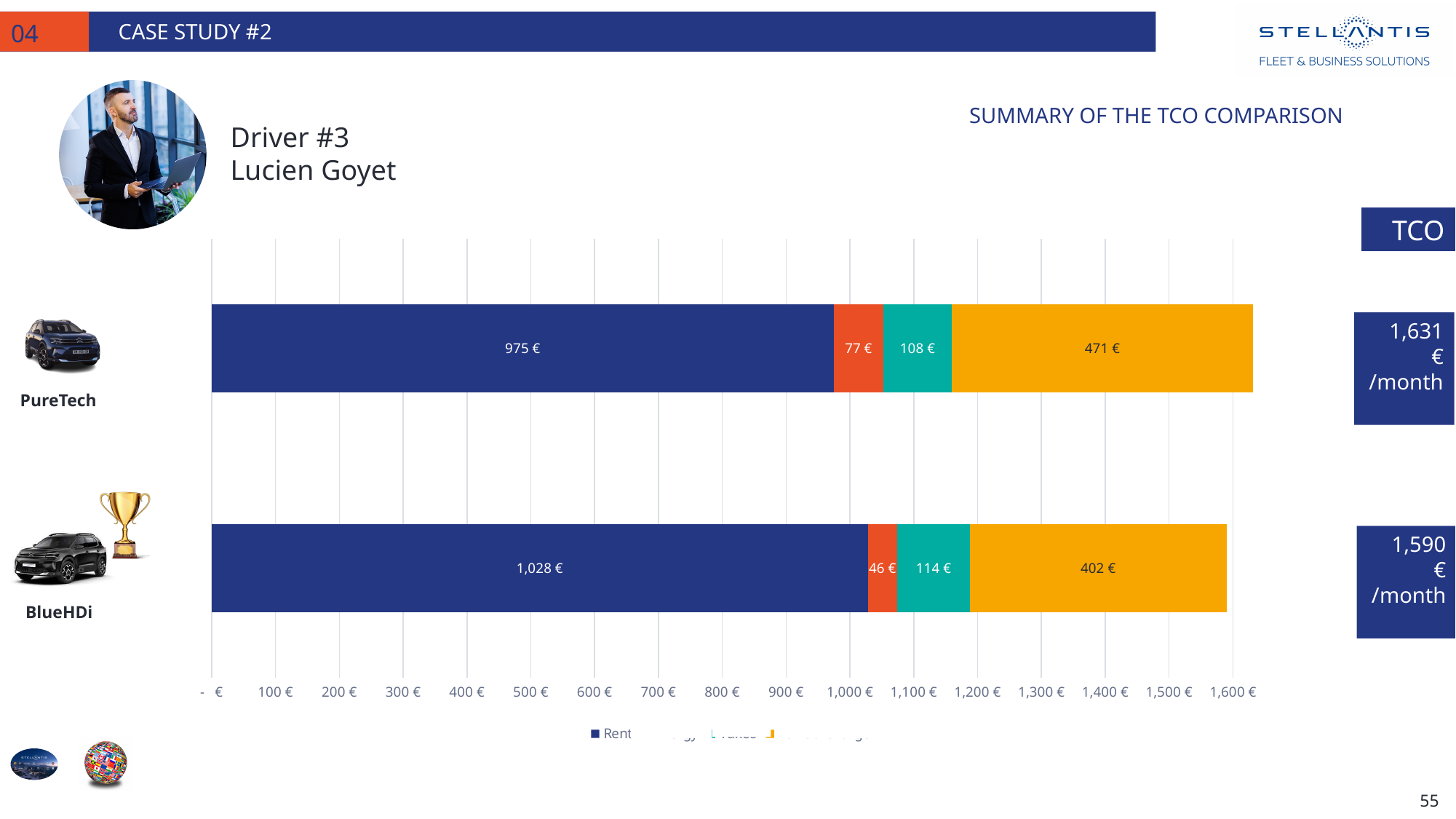
What is the total TCO per month shown for BlueHDi? 1,590 € /month What is the Taxes (teal segment) value for BlueHDi? 114 € Is the total bar length for BlueHDi greater or less than 1,600 €? less What is the total TCO per month shown for PureTech? 1,631 € /month What is the value of the yellow segment for PureTech? 471 € What is the value of the orange segment for BlueHDi? 46 € Which option has the higher total TCO, PureTech or BlueHDi? PureTech How much higher is the Rent for BlueHDi than for PureTech? 53 € What is the Rent value for PureTech? 975 € What kind of chart is shown on the slide? Stacked bar chart What is the Rent value for BlueHDi? 1,028 € How many vehicle options (categories) are plotted in the chart? 2